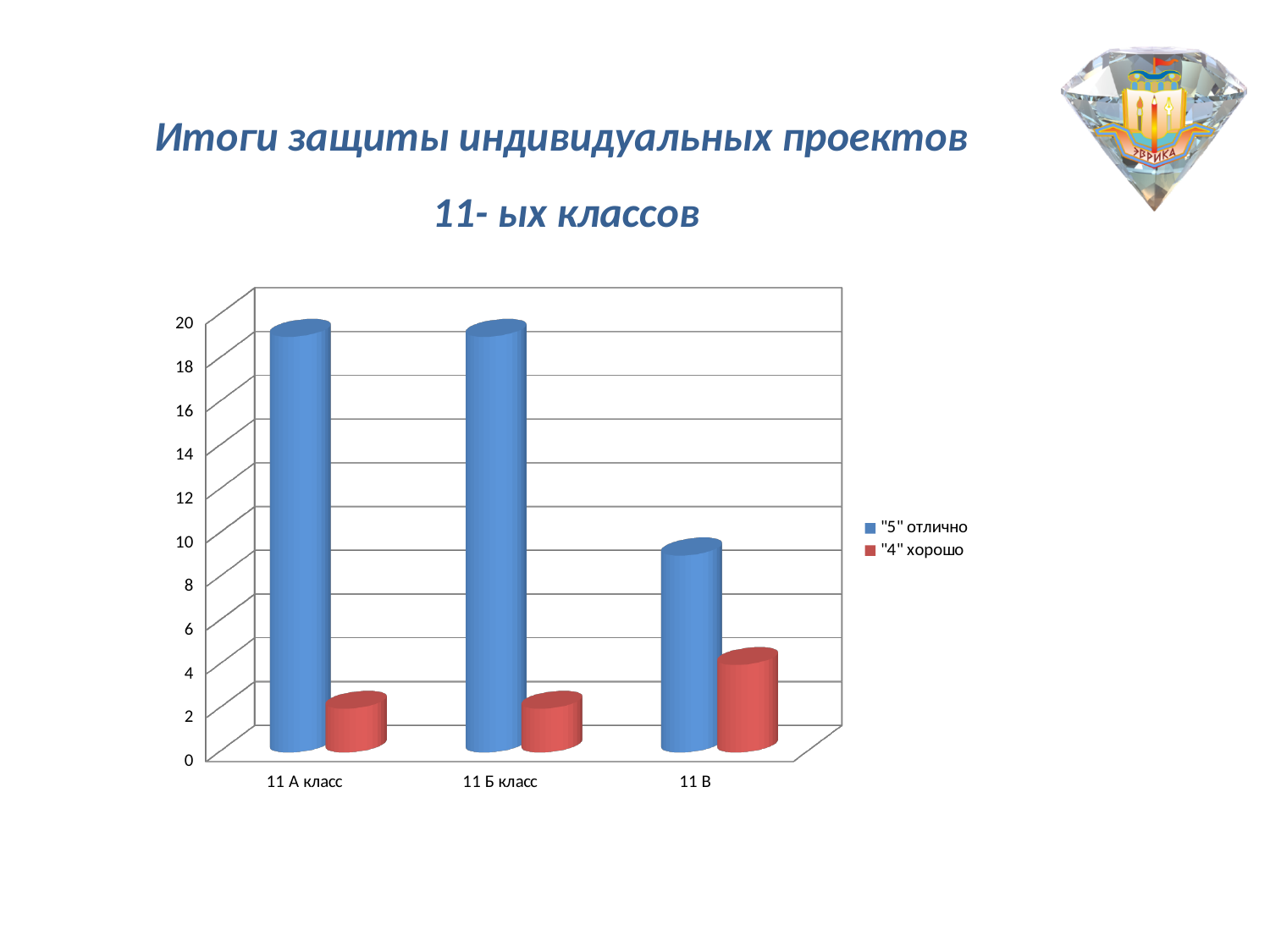
What kind of chart is shown on the slide? bar chart Which class has the highest value for the "4" хорошо series? 11 В Which colour represents the "4" хорошо series in the legend? red Is the "4" хорошо value for 11 В greater or less than 6? less Which is larger: the "4" хорошо value for 11 В or for 11 А класс? 11 В Is the "4" хорошо value for 11 А класс greater or less than 4? less Which is larger: the "5" отлично value for 11 Б класс or for 11 В? 11 Б класс Is the "5" отлично value for 11 В greater or less than 14? less How many classes (categories) are shown on the x axis? 3 Which class has the lowest value for the "5" отлично series? 11 В How many series does the legend list? 2